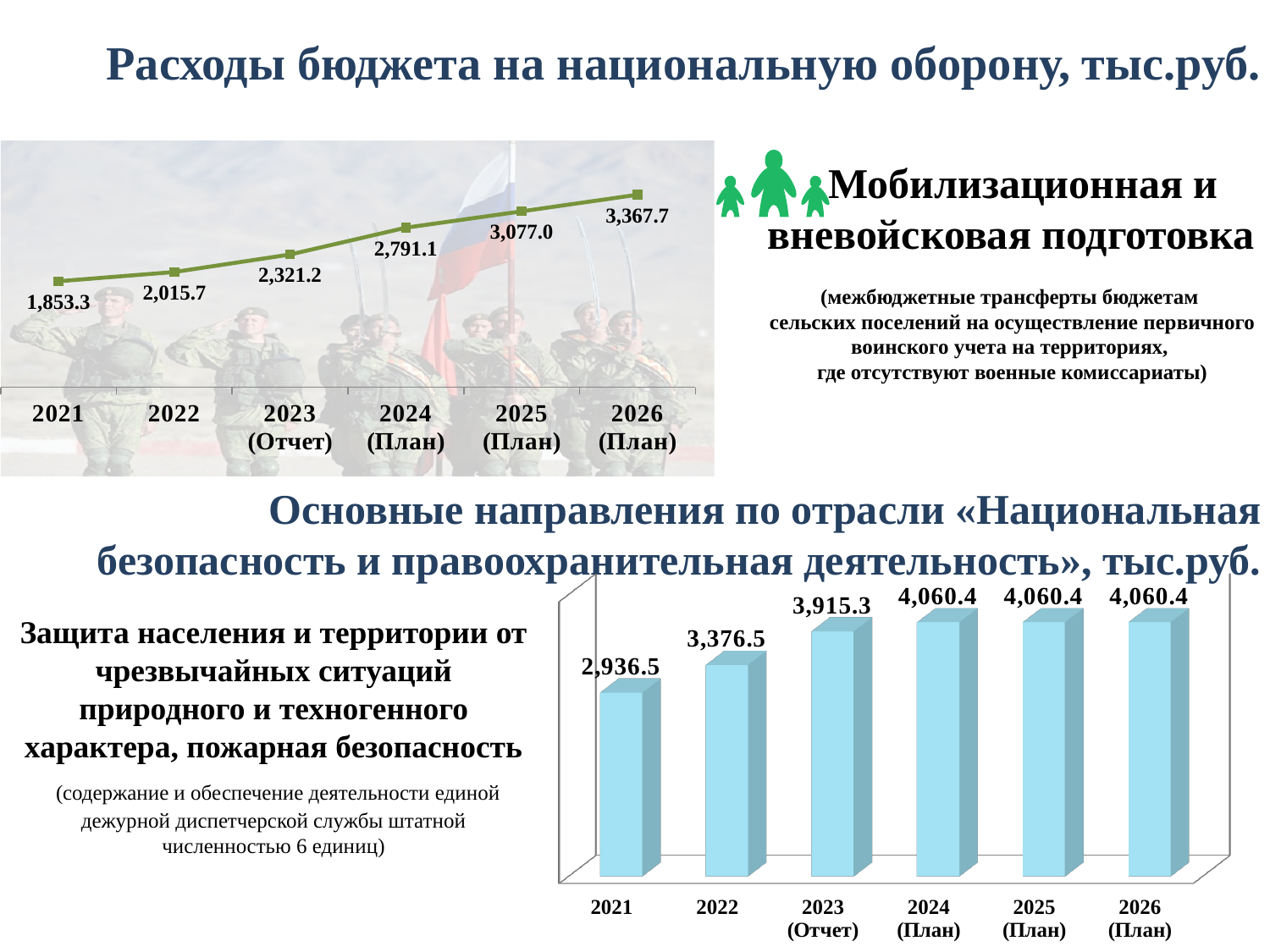
In the top line chart on national defence expenditures, what is the value for 2024 (План)? 2,791.1 What type of chart is the bottom chart on national security? bar chart What type of chart is the top chart on national defence expenditures? line chart In the bottom bar chart on national security, what is the value for 2021? 2,936.5 In the top line chart on national defence expenditures, what is the value for 2021? 1,853.3 In the bottom bar chart on national security, what is the value for 2023 (Отчет)? 3,915.3 In the top line chart on national defence expenditures, do the values rise or fall from 2021 to 2026? rise In the top line chart on national defence expenditures, which year has the highest value? 2026 (План) In the top line chart on national defence expenditures, what is the difference between the 2026 (План) and 2025 (План) values? 290.7 How many years are shown in the bottom bar chart on national security? 6 In the bottom bar chart on national security, which year has the lowest value? 2021 In the bottom bar chart on national security, what is the difference between the 2022 and 2021 values? 440.0